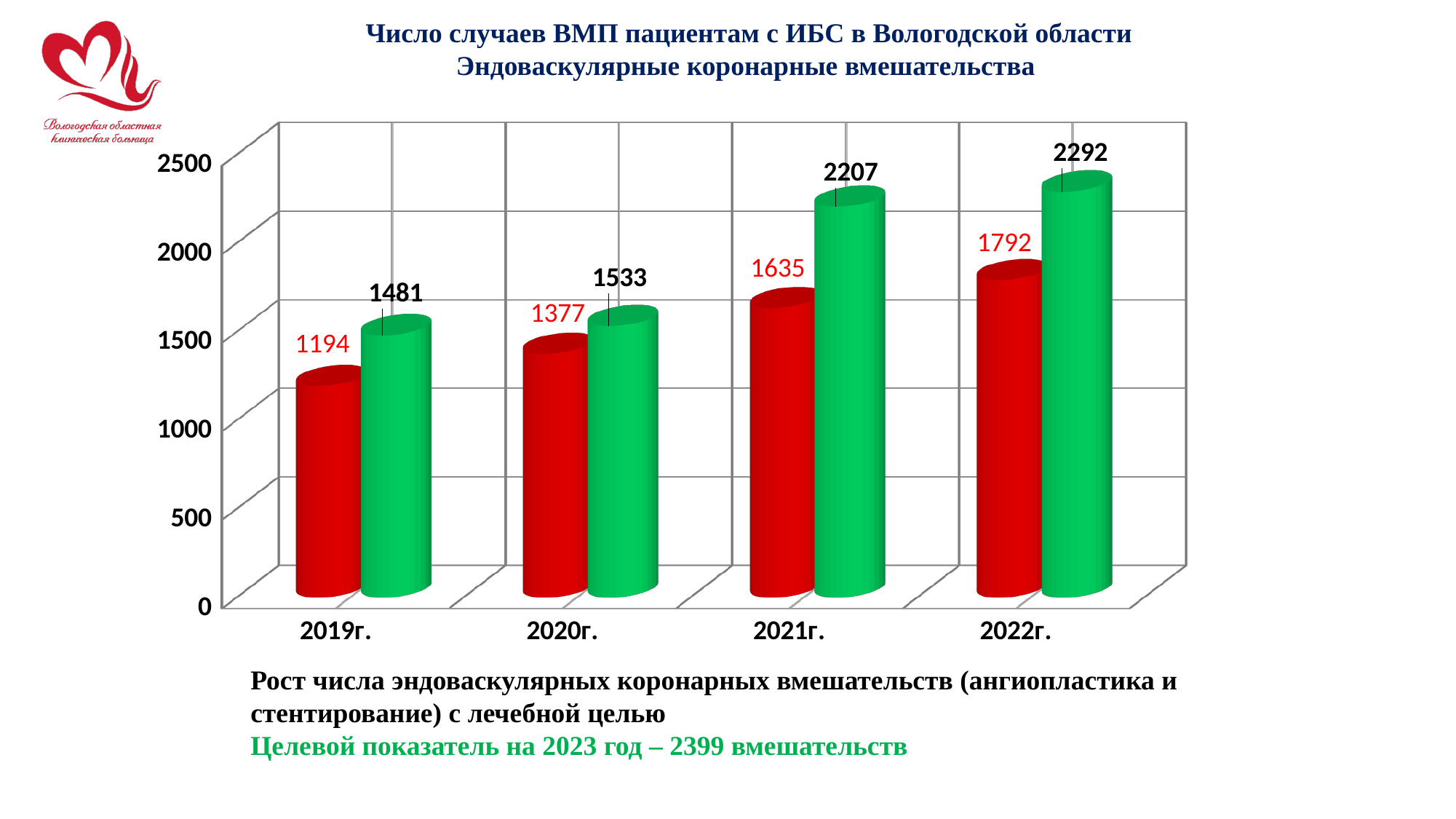
What is the value of the red bar for 2022г.? 1792 Which year has the highest green bar? 2022г. Which year has the lowest red bar? 2019г. What is the value of the red bar for 2019г.? 1194 What is the difference between the green and red bars for 2021г.? 572 Which is larger: the red bar for 2022г. or the green bar for 2020г.? the red bar for 2022г. What is the value of the green bar for 2020г.? 1533 How many years are shown on the x axis? 4 Do the green bar values rise or fall from 2019г. to 2022г.? rise What kind of chart is shown on the slide? bar chart What is the difference between the green bar for 2022г. and the green bar for 2019г.? 811 What is the value of the green bar for 2021г.? 2207